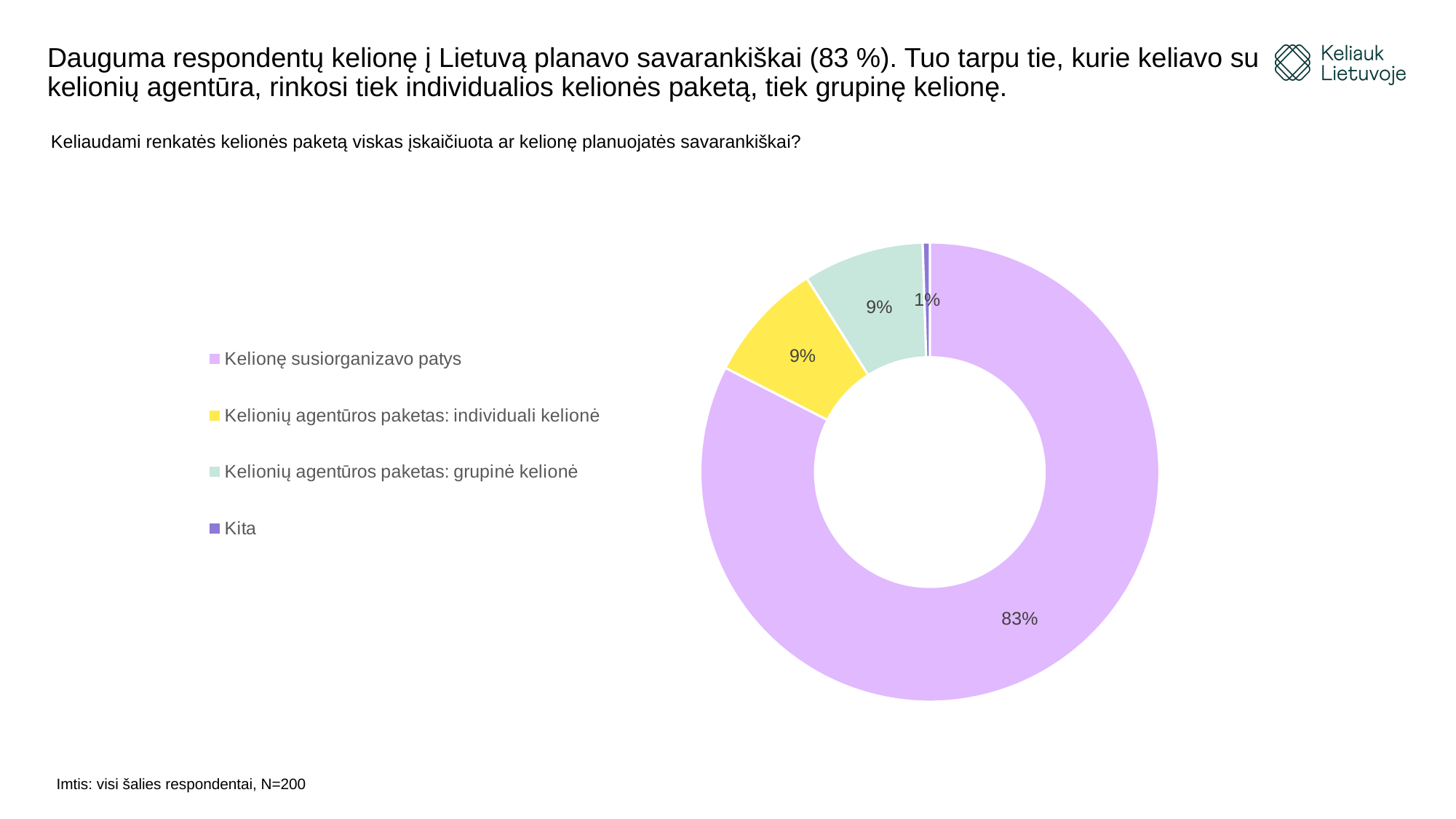
What share of respondents organised the trip themselves (Kelionę susiorganizavo patys)? 83% Which category has the smallest share of the chart? Kita What kind of chart is shown on the slide? doughnut chart What colour is the slice for Kelionių agentūros paketas: individuali kelionė? yellow What share of the chart is labelled Kita? 1% What percentage chose a travel agency package for a group trip (Kelionių agentūros paketas: grupinė kelionė)? 9% Which is larger: the share for Kelionių agentūros paketas: grupinė kelionė or the share for Kita? Kelionių agentūros paketas: grupinė kelionė Which category has the largest share of the chart? Kelionę susiorganizavo patys What is the difference in percentage points between Kelionę susiorganizavo patys and Kelionių agentūros paketas: individuali kelionė? 74 What percentage chose a travel agency package for an individual trip (Kelionių agentūros paketas: individuali kelionė)? 9% How many categories does the chart show? 4 What is the difference in percentage points between Kelionę susiorganizavo patys and Kita? 82